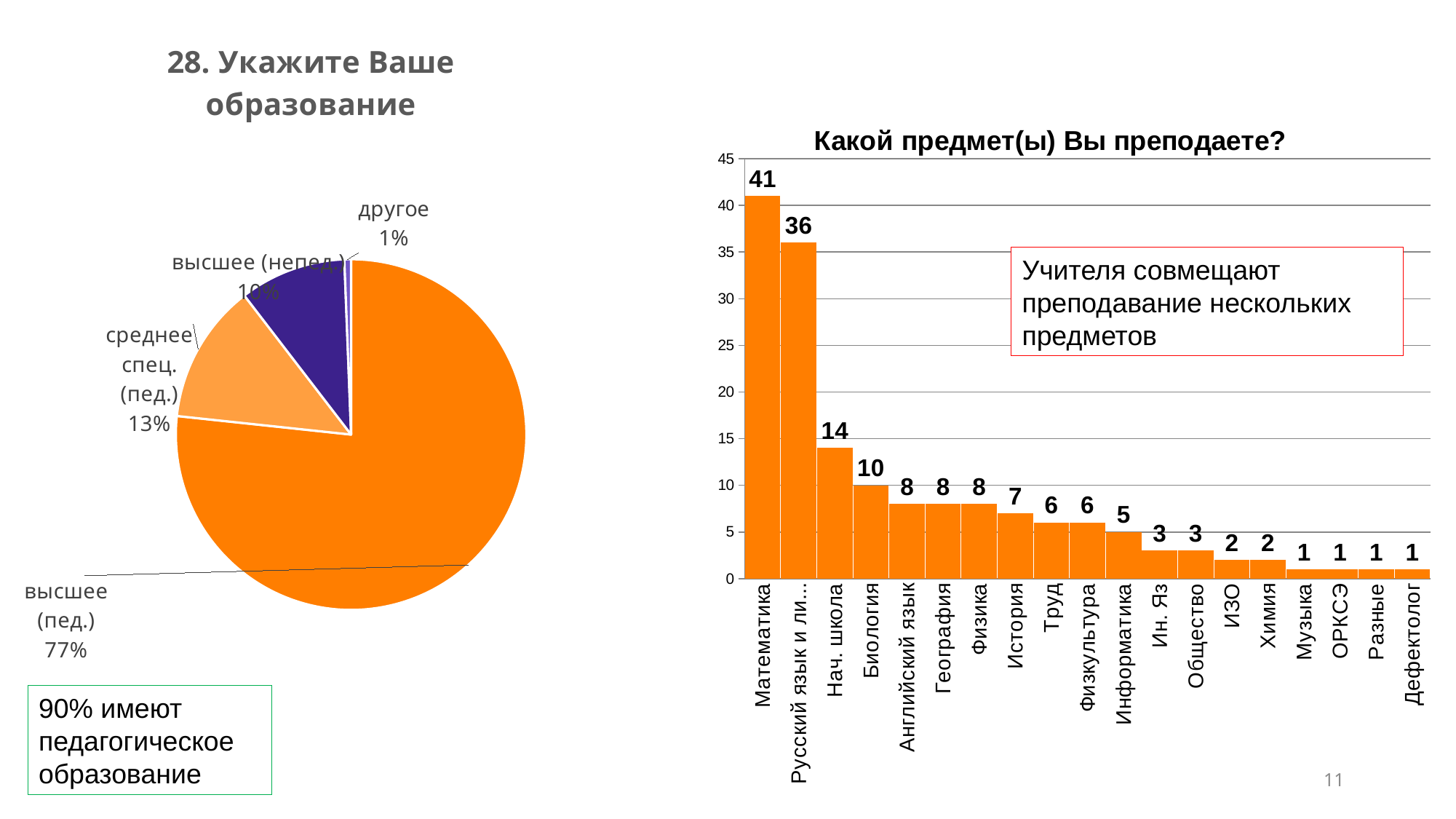
What kind of chart is 'Какой предмет(ы) Вы преподаете?'? bar chart In the chart 'Какой предмет(ы) Вы преподаете?', do the values rise or fall from left to right along the x axis? fall In the chart 'Какой предмет(ы) Вы преподаете?', what is the difference between the values for Математика and Биология? 31 In the chart 'Какой предмет(ы) Вы преподаете?', how many subject categories are shown on the x axis? 19 In the chart 'Какой предмет(ы) Вы преподаете?', which is larger, the value for История or the value for Информатика? История In the pie chart '28. Укажите Ваше образование', how many slices are there? 4 In the pie chart '28. Укажите Ваше образование', what share is shown for 'высшее (пед.)'? 77% In the chart 'Какой предмет(ы) Вы преподаете?', what is the value for Математика? 41 In the pie chart '28. Укажите Ваше образование', what share is shown for 'среднее спец. (пед.)'? 13% In the pie chart '28. Укажите Ваше образование', which category has the smallest slice? другое In the chart 'Какой предмет(ы) Вы преподаете?', what is the value for Нач. школа? 14 In the chart 'Какой предмет(ы) Вы преподаете?', which subject has the highest value? Математика